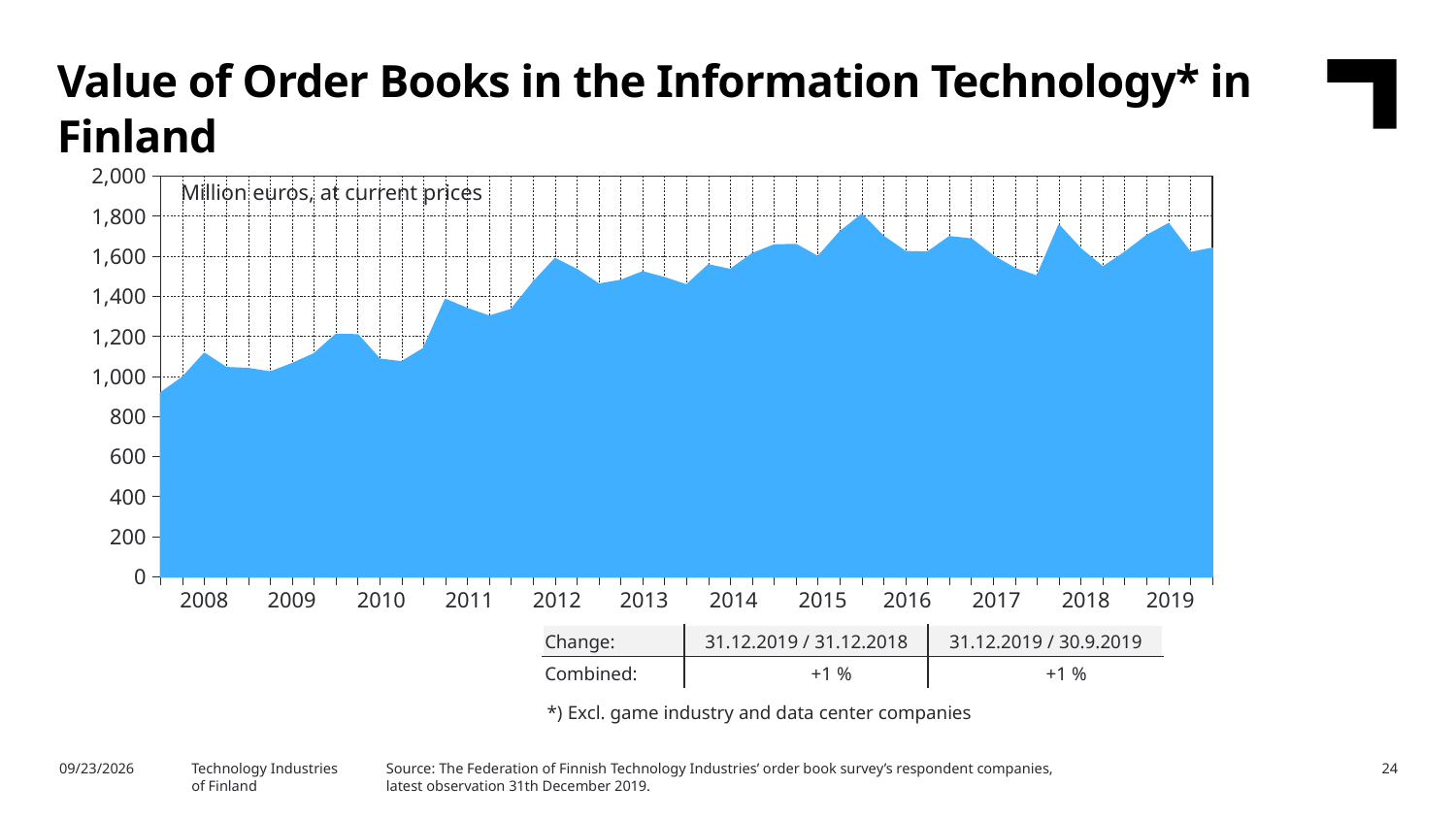
Which is larger, the value of order books in 2008 or in 2019? 2019 In which year does the chart show its lowest value? 2008 Is the peak value reached in 2015 greater or less than 1,600? greater Is the value at the start of 2008 greater or less than 1,000? less How many years are labeled on the x axis of the chart? 12 What is the title of the chart on the slide? Value of Order Books in the Information Technology* in Finland Is the value in 2010 greater or less than 1,400? less What unit is the chart measured in, according to the label inside the plot area? Million euros, at current prices What type of chart is shown on the slide? area chart Overall, do the values rise or fall from 2008 to 2019? rise What is the combined change for 31.12.2019 / 31.12.2018 shown in the table below the chart? +1 %